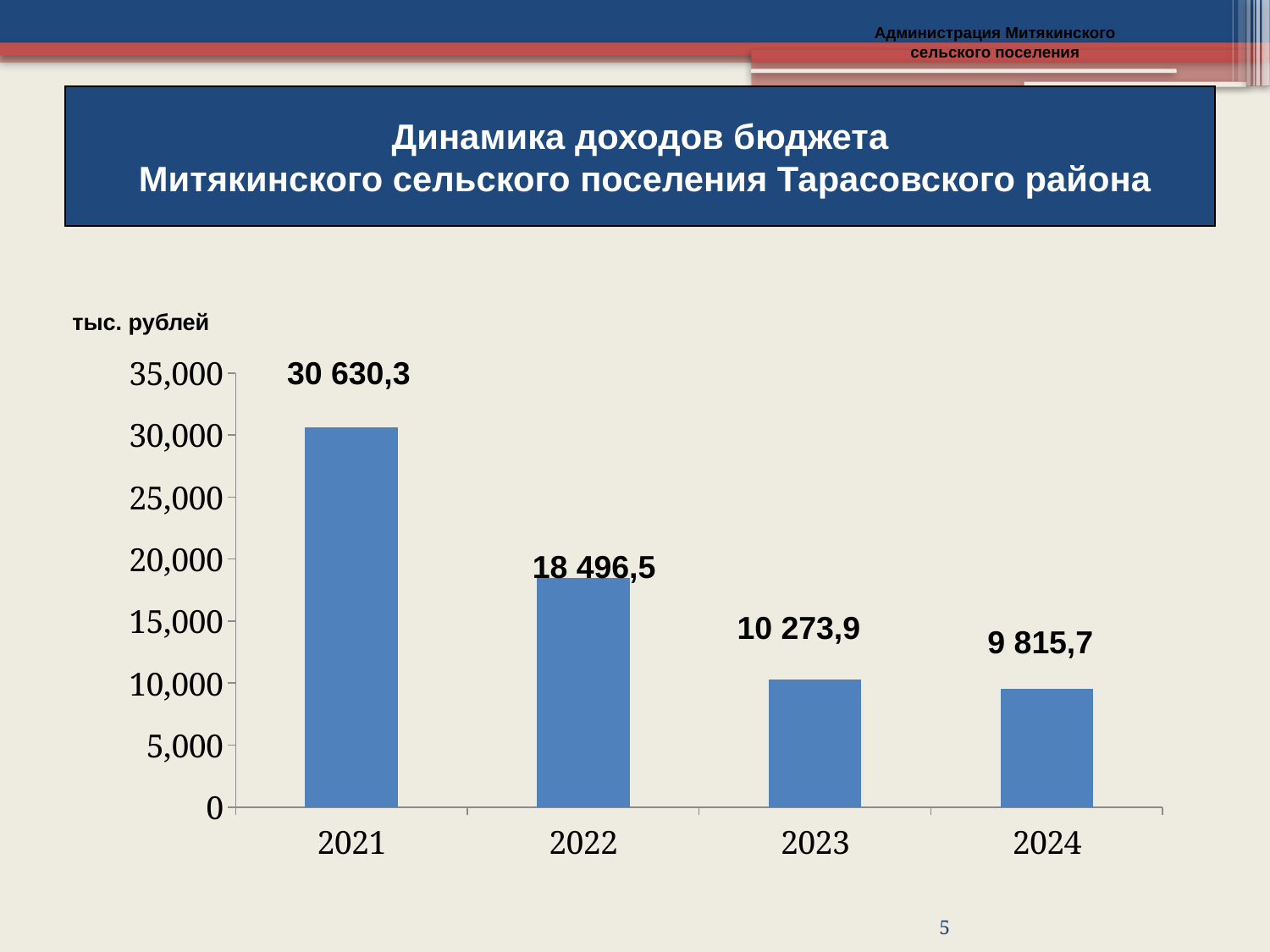
Is the value for 2024 greater or less than 10,000? less Which is larger, the value for 2022 or the value for 2023? 2022 What is the budget revenue value shown for 2024? 9 815,7 Which year has the highest budget revenue? 2021 What is the difference between the 2023 and 2024 values? 458,2 What is the difference between the 2021 and 2022 values? 12 133,8 What is the budget revenue value shown for 2023? 10 273,9 What is the budget revenue value shown for 2021? 30 630,3 How many years are shown on the x axis of the chart? 4 Do the values rise or fall from 2021 to 2024? fall Which year has the lowest budget revenue? 2024 What is the budget revenue value shown for 2022? 18 496,5